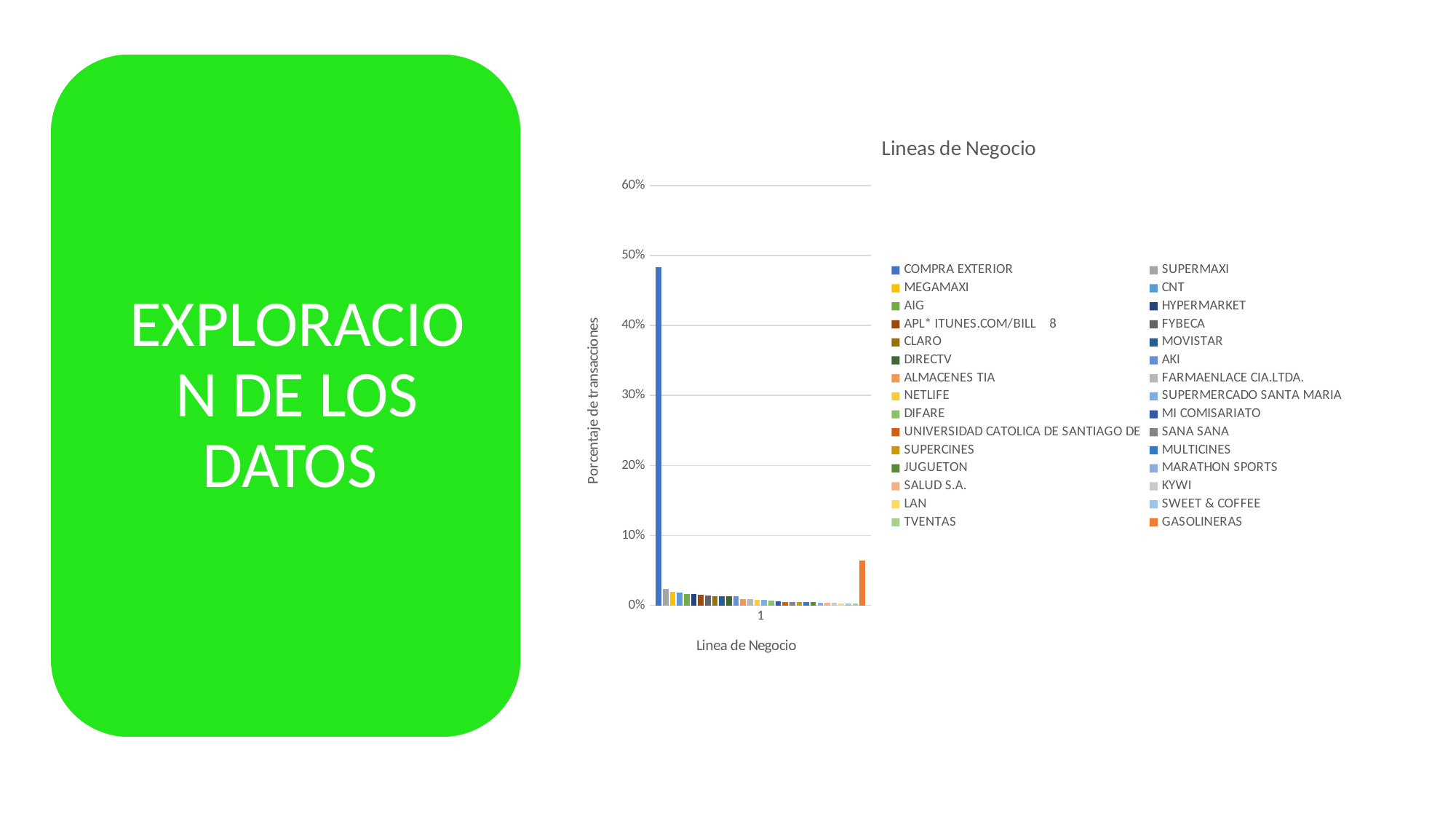
Is the value for COMPRA EXTERIOR greater or less than 50%? less How many categories are shown on the x axis of the chart? 1 What is the title of the chart? Lineas de Negocio Which is larger, the value for GASOLINERAS or the value for SUPERMAXI? GASOLINERAS Which is larger, the value for COMPRA EXTERIOR or the value for GASOLINERAS? COMPRA EXTERIOR Is the value for GASOLINERAS greater or less than 10%? less Which series has the highest value in the chart? COMPRA EXTERIOR Is the value for SUPERMAXI greater or less than 10%? less What kind of chart is shown on the slide? bar chart How many series does the chart's legend list? 30 What is the label of the vertical axis of the chart? Porcentaje de transacciones